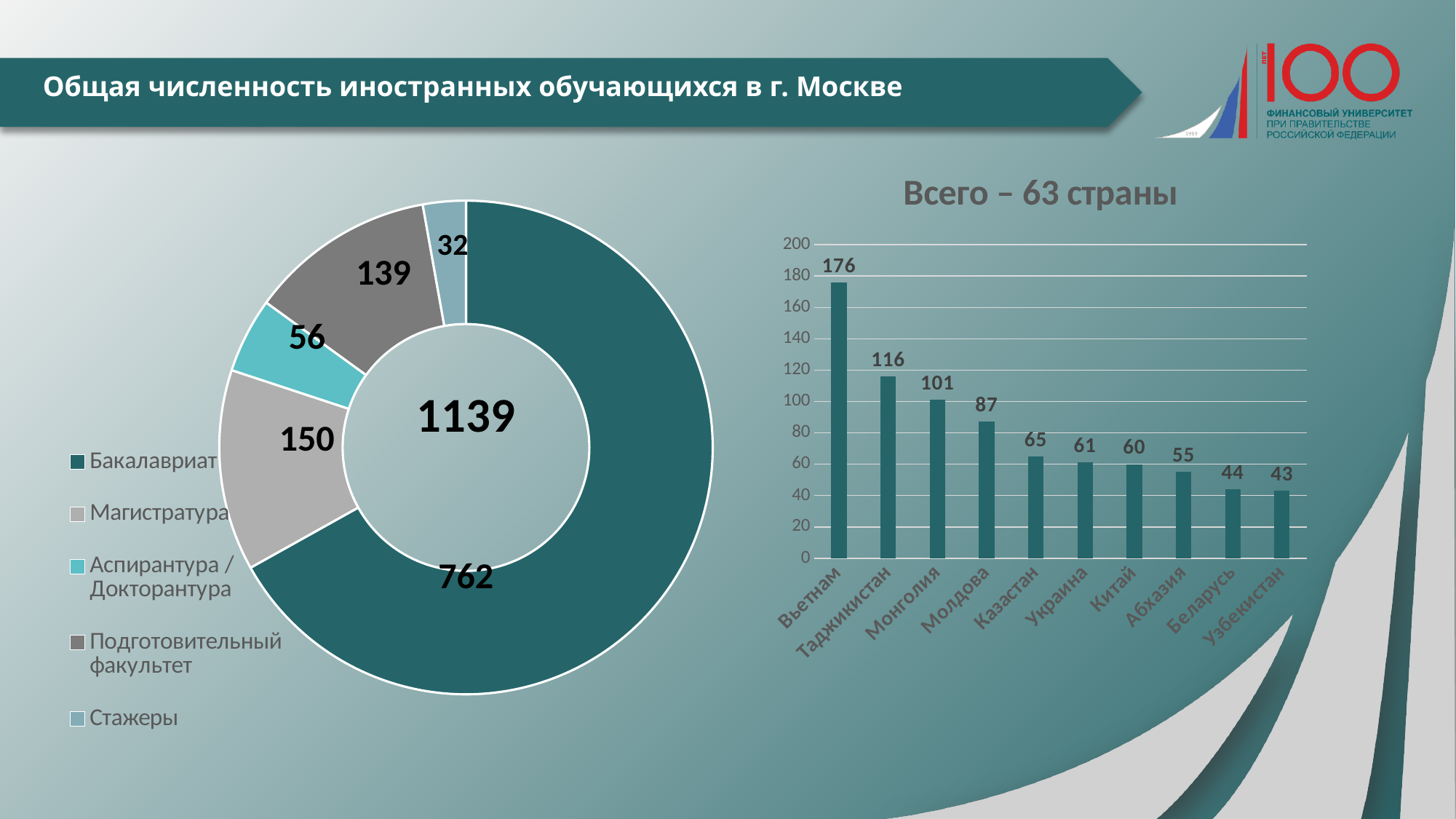
In the doughnut chart on the left, what is the value for Бакалавриат? 762 What number is shown in the centre of the doughnut chart on the left? 1139 In the bar chart titled 'Всего – 63 страны', which country has the lowest value? Узбекистан In the doughnut chart on the left, what is the difference between Магистратура and Аспирантура / Докторантура? 94 In the bar chart titled 'Всего – 63 страны', what is the value for Монголия? 101 In the bar chart titled 'Всего – 63 страны', how many countries are shown? 10 In the bar chart titled 'Всего – 63 страны', what is the difference between Вьетнам and Таджикистан? 60 In the bar chart titled 'Всего – 63 страны', which country has the highest value? Вьетнам In the bar chart titled 'Всего – 63 страны', do the values rise or fall from left to right? fall In the doughnut chart on the left, what is the value for Подготовительный факультет? 139 In the doughnut chart on the left, how many categories does the legend list? 5 In the doughnut chart on the left, which category has the smallest value? Стажеры